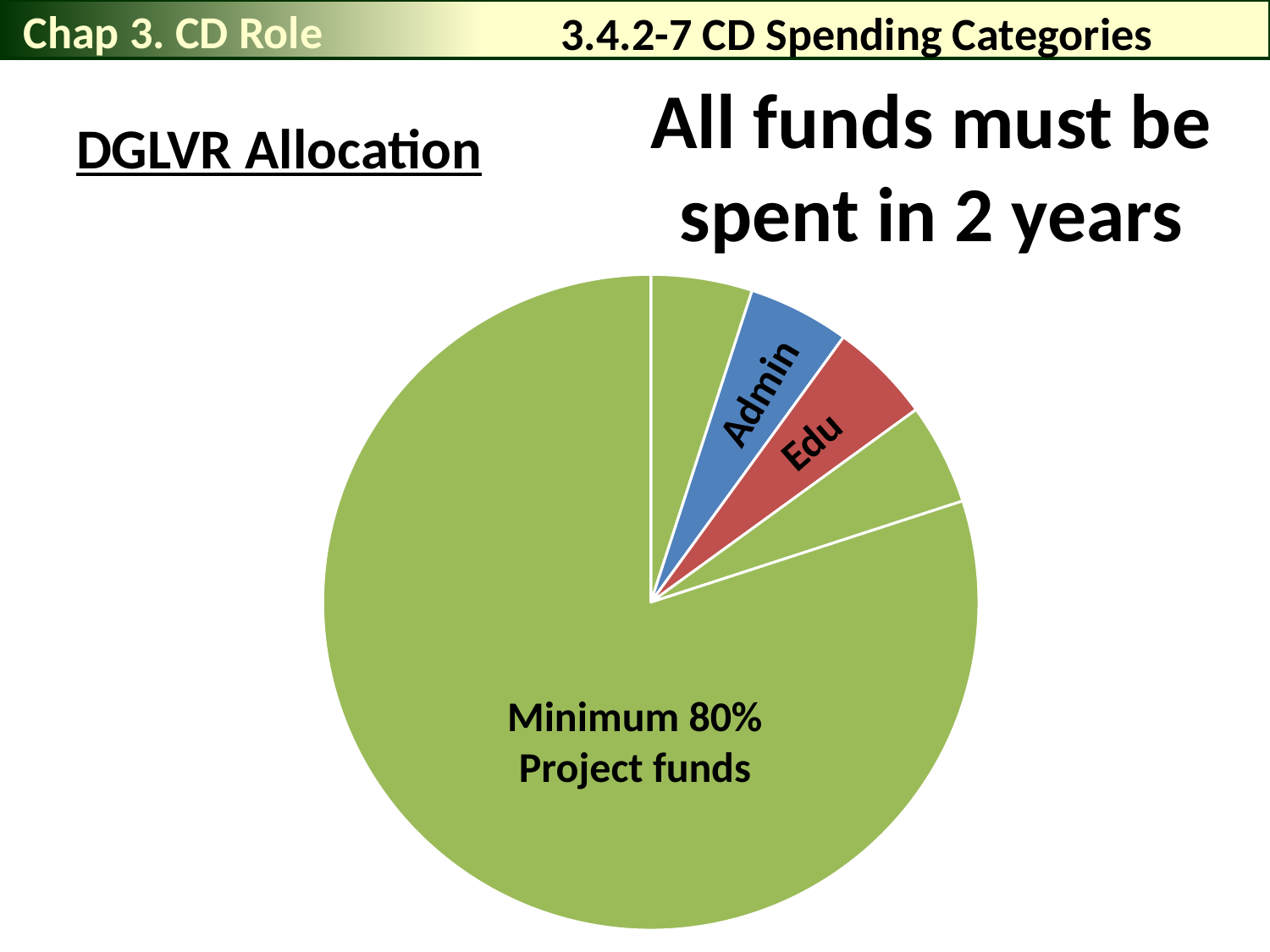
Which is larger in the pie chart, the Project funds slice or the Edu slice? Project funds What colour is the Admin slice in the pie chart? blue What kind of chart is shown on the slide? pie chart What is the title of the pie chart? DGLVR Allocation How many slices does the pie chart have? 5 What minimum share of the pie is labelled for Project funds? Minimum 80% What colour is the Edu slice in the pie chart? red Which slice of the pie chart is the largest? Minimum 80% Project funds Which is larger in the pie chart, the Project funds slice or the Admin slice? Project funds